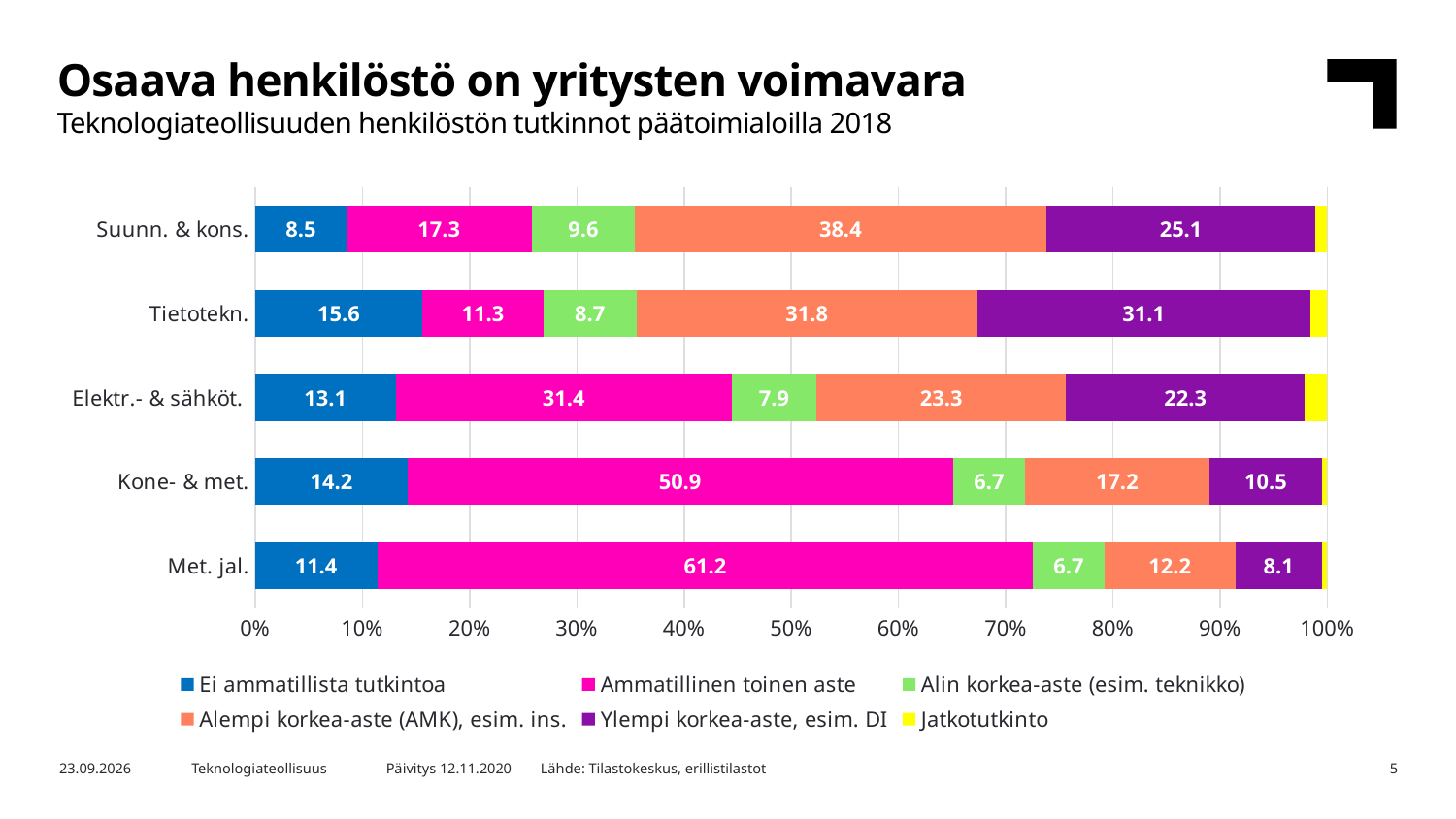
What is the value for Alempi korkea-aste (AMK), esim. ins. in the Suunn. & kons. bar? 38.4 What is the value for Ylempi korkea-aste, esim. DI in the Tietotekn. bar? 31.1 What is the difference between the Ammatillinen toinen aste values for Met. jal. and Kone- & met.? 10.3 Which is larger: the Ylempi korkea-aste, esim. DI value for Suunn. & kons. or for Elektr.- & sähköt.? Suunn. & kons. Which category has the highest value for Ammatillinen toinen aste? Met. jal. Which category has the lowest value for Ei ammatillista tutkintoa? Suunn. & kons. What is the value for Ammatillinen toinen aste in the Met. jal. bar? 61.2 Which series is shown in yellow in the legend? Jatkotutkinto What kind of chart is shown on the slide? Stacked bar chart How many series does the legend list? 6 How many categories are shown on the vertical axis? 5 What is the difference between the Ei ammatillista tutkintoa values for Tietotekn. and Met. jal.? 4.2